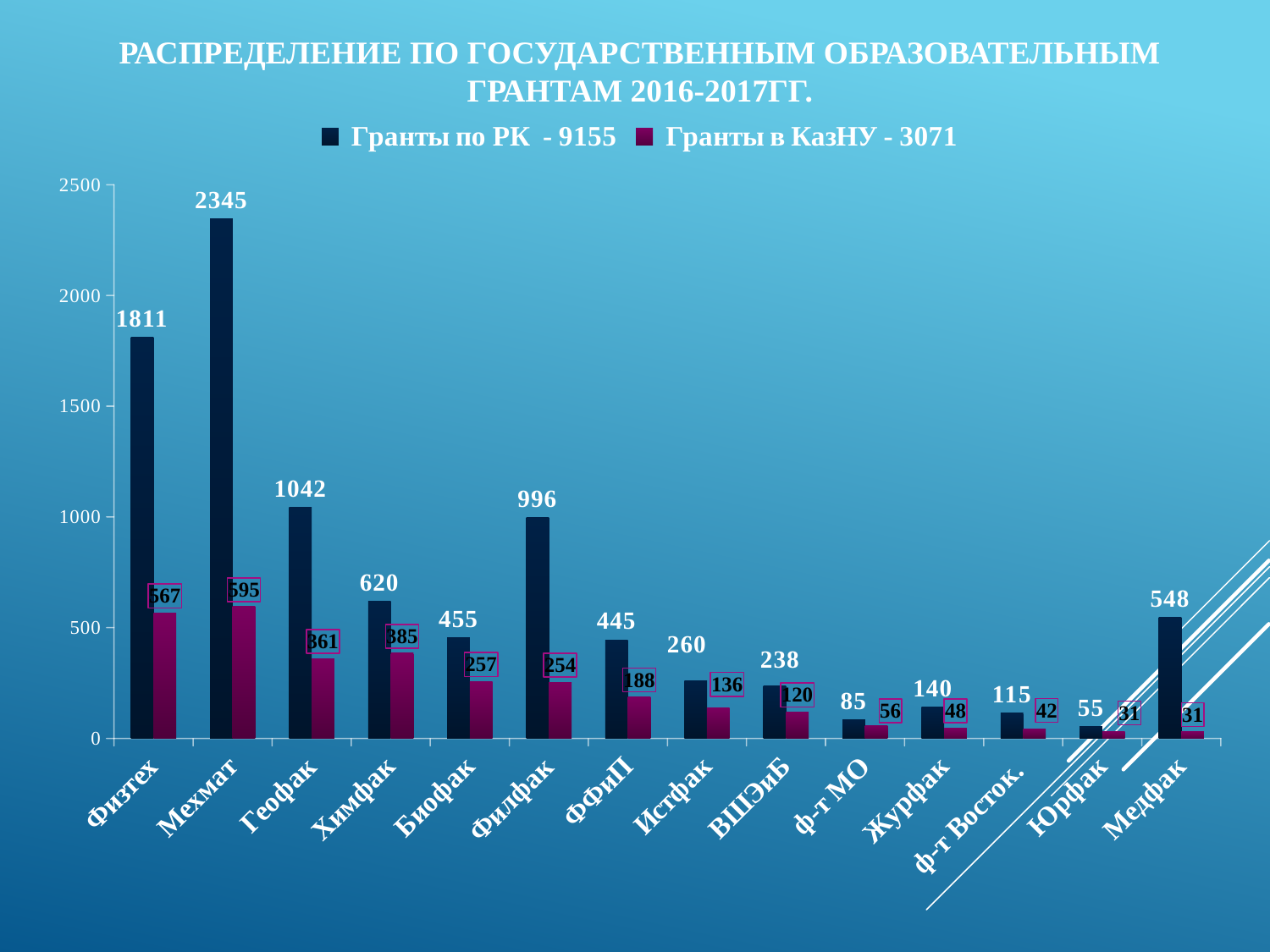
Which has a larger Гранты по РК value, Химфак or Медфак? Химфак What is the difference between the Гранты по РК values for Геофак and Филфак? 46 What is the value of Гранты в КазНУ for ф-т МО? 56 What kind of chart is shown on the slide? Bar chart How many series does the legend list? 2 Which faculty has the lowest value for Гранты по РК? Юрфак What total is given in the legend for Гранты в КазНУ? 3071 What is the value of Гранты по РК for Мехмат? 2345 What is the value of Гранты в КазНУ for Биофак? 257 What is the value of Гранты по РК for Физтех? 1811 How many faculties are shown on the x axis? 14 Which faculty has the highest value for Гранты по РК? Мехмат